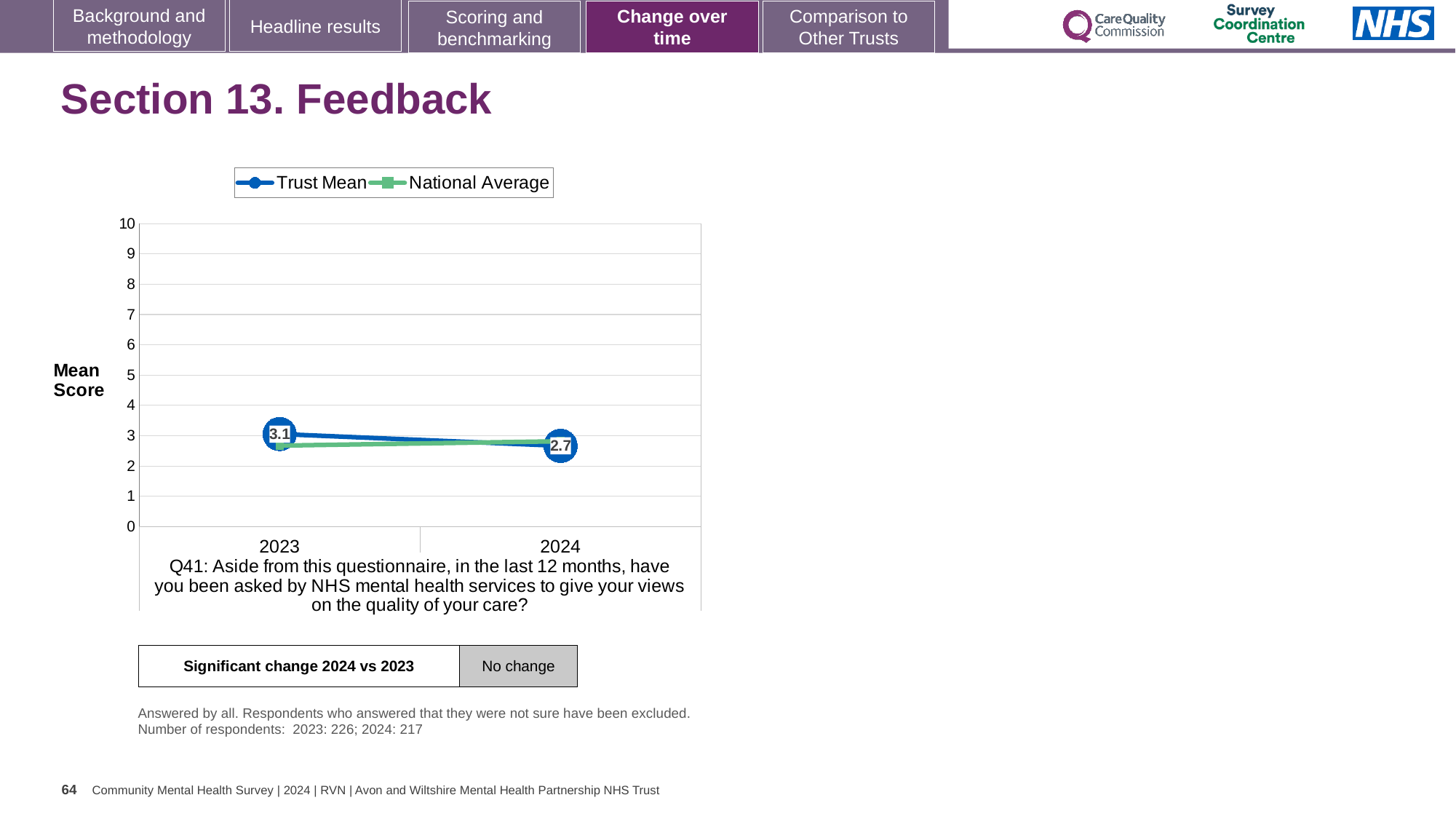
By how much did the Trust Mean change from 2023 to 2024? 0.4 How many years are plotted on the x axis? 2 Is the Trust Mean value for 2023 greater or less than 4? less What is the Trust Mean value for 2023? 3.1 What are the two series named in the legend? Trust Mean and National Average What kind of chart is shown on the slide? line chart What is the Trust Mean value for 2024? 2.7 Does the Trust Mean rise or fall from 2023 to 2024? fall How many series does the legend list? 2 What is the label on the y axis of the chart? Mean Score Is the National Average value for 2024 greater or less than 5? less In which year was the Trust Mean higher, 2023 or 2024? 2023